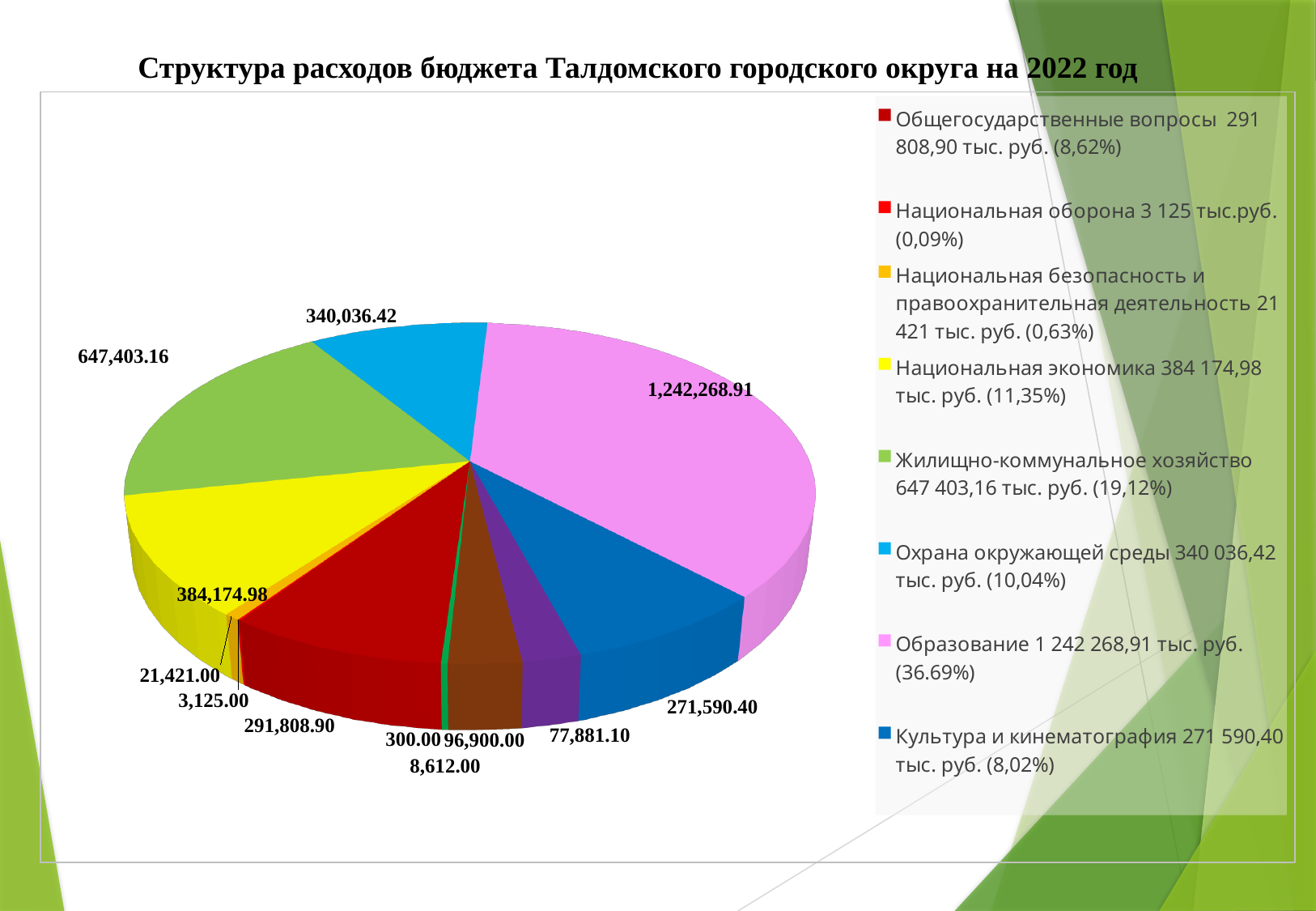
Which is larger: the value for Национальная экономика or the value for Охрана окружающей среды? Национальная экономика Which category has the largest slice of the pie? Образование What is the value of the Жилищно-коммунальное хозяйство slice according to its data label? 647,403.16 What is the value of the Образование slice according to its data label? 1,242,268.91 What is the difference between the Жилищно-коммунальное хозяйство value (647,403.16) and the Охрана окружающей среды value (340,036.42)? 307,366.74 What is the smallest value shown among the data labels on the pie? 300.00 What is the value of the Охрана окружающей среды slice according to its data label? 340,036.42 What kind of chart is shown on the slide? Pie chart What is the title of the chart? Структура расходов бюджета Талдомского городского округа на 2022 год What share of the pie does Образование represent, as given in the legend? 36.69% How many data labels are shown on the pie chart? 12 What share of the pie does Жилищно-коммунальное хозяйство represent, as given in the legend? 19,12%